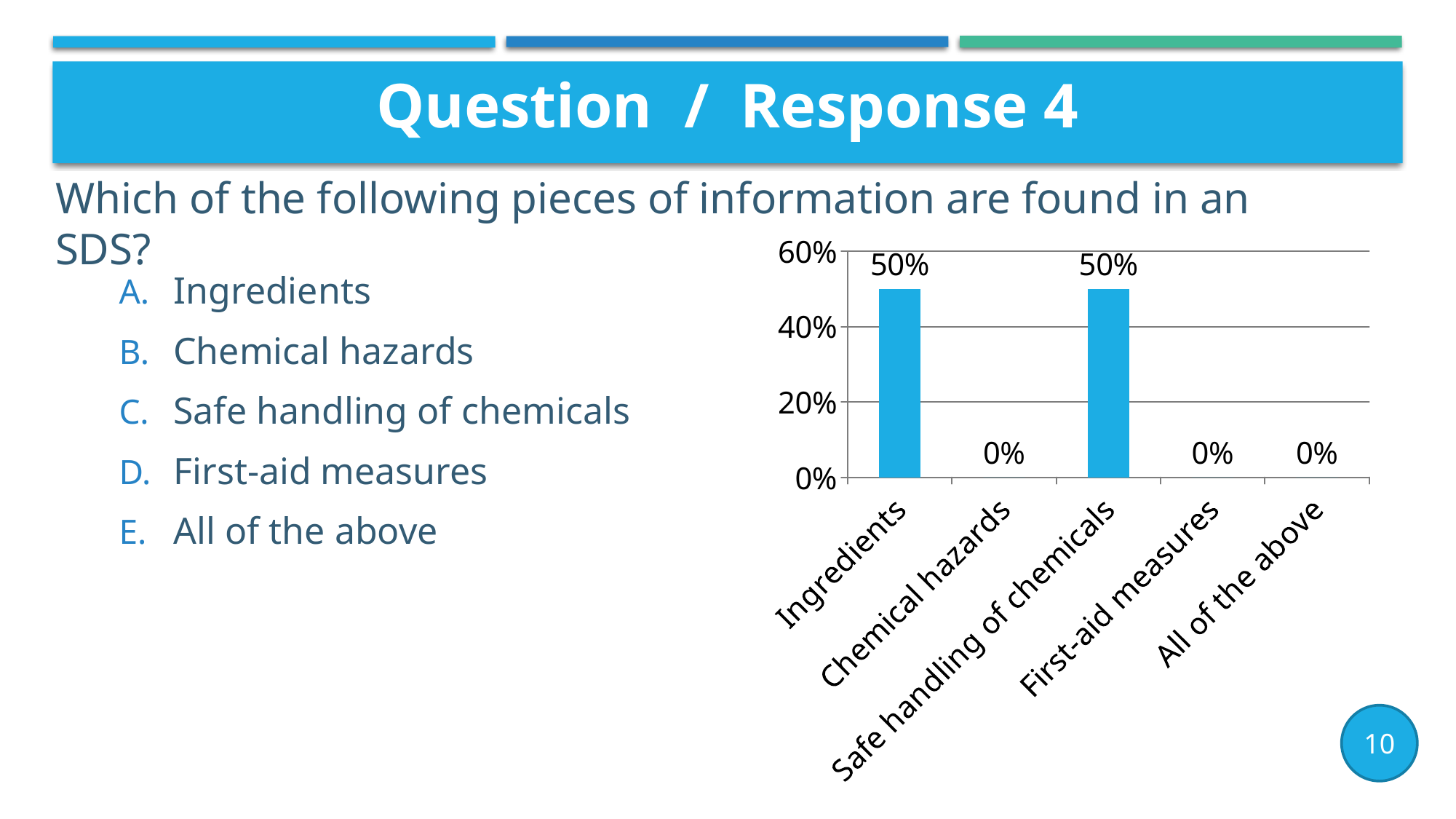
How many categories are shown on the x axis of the chart? 5 What is the value for All of the above? 0% What kind of chart is shown on the slide? bar chart What is the highest value shown on the y axis of the chart? 60% What is the value for First-aid measures? 0% Is the value for Ingredients greater or less than 40%? greater What is the value for Chemical hazards? 0% What is the difference between the values for Ingredients and Chemical hazards? 50% How many categories have a value of 0%? 3 What is the value for Safe handling of chemicals? 50% What is the value for Ingredients? 50% Which is larger, the value for Safe handling of chemicals or the value for First-aid measures? Safe handling of chemicals